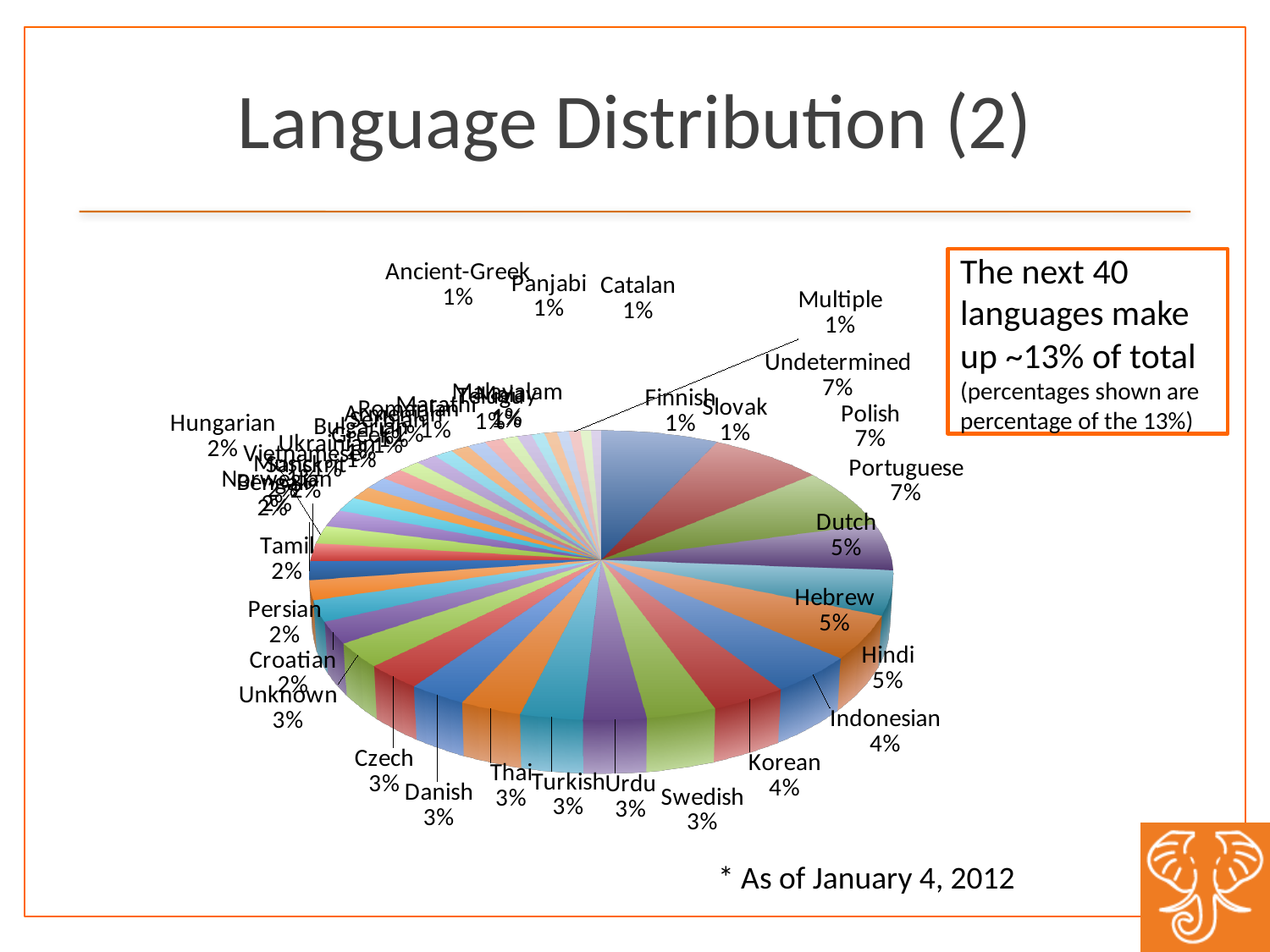
What is the difference in percentage points between Polish and Dutch? 2% What percentage is shown for Dutch? 5% What percentage is shown for Tamil? 2% What percentage is shown for Czech? 3% According to the footnote, as of what date is the data shown? January 4, 2012 What percentage is shown for Catalan? 1% What percentage is shown for Indonesian? 4% Which has the larger share, Undetermined or Hindi? Undetermined What kind of chart is shown on the slide? pie chart What percentage is shown for Polish? 7% What percentage is shown for Portuguese? 7% Which has the larger share, Hebrew or Korean? Hebrew